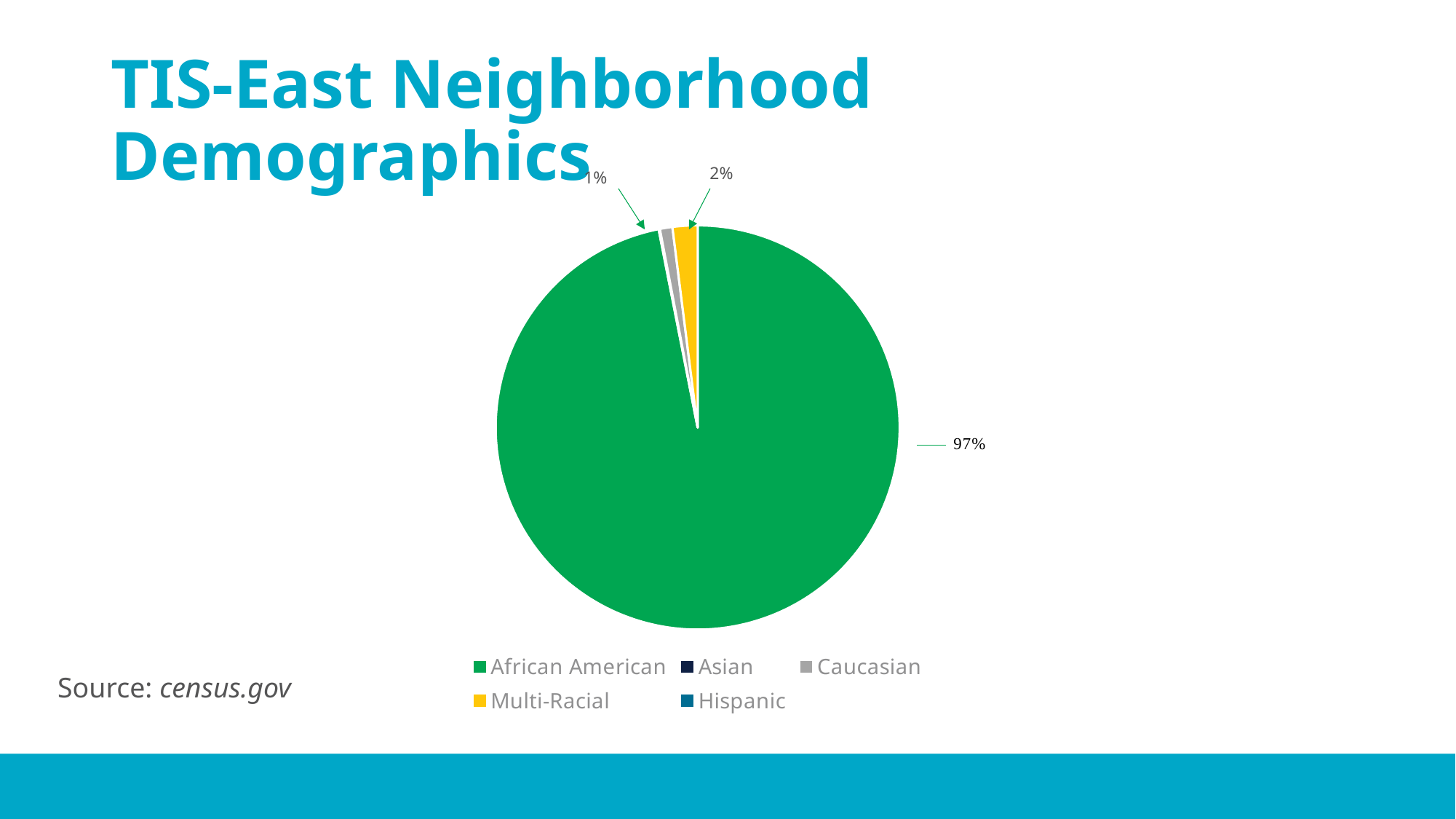
What percentage of the pie chart is African American? 97% Which category has the largest share of the pie chart? African American What percentage of the pie chart is Caucasian? 1% What colour is the African American slice of the pie chart? Green What percentage of the pie chart is Multi-Racial? 2% Which is larger, the Multi-Racial share or the Caucasian share? Multi-Racial What is the title of the slide? TIS-East Neighborhood Demographics What kind of chart is shown on the slide? Pie chart What is the difference in percentage points between the African American share and the Multi-Racial share? 95 How many categories does the legend list? 5 What is the difference in percentage points between the Multi-Racial share and the Caucasian share? 1